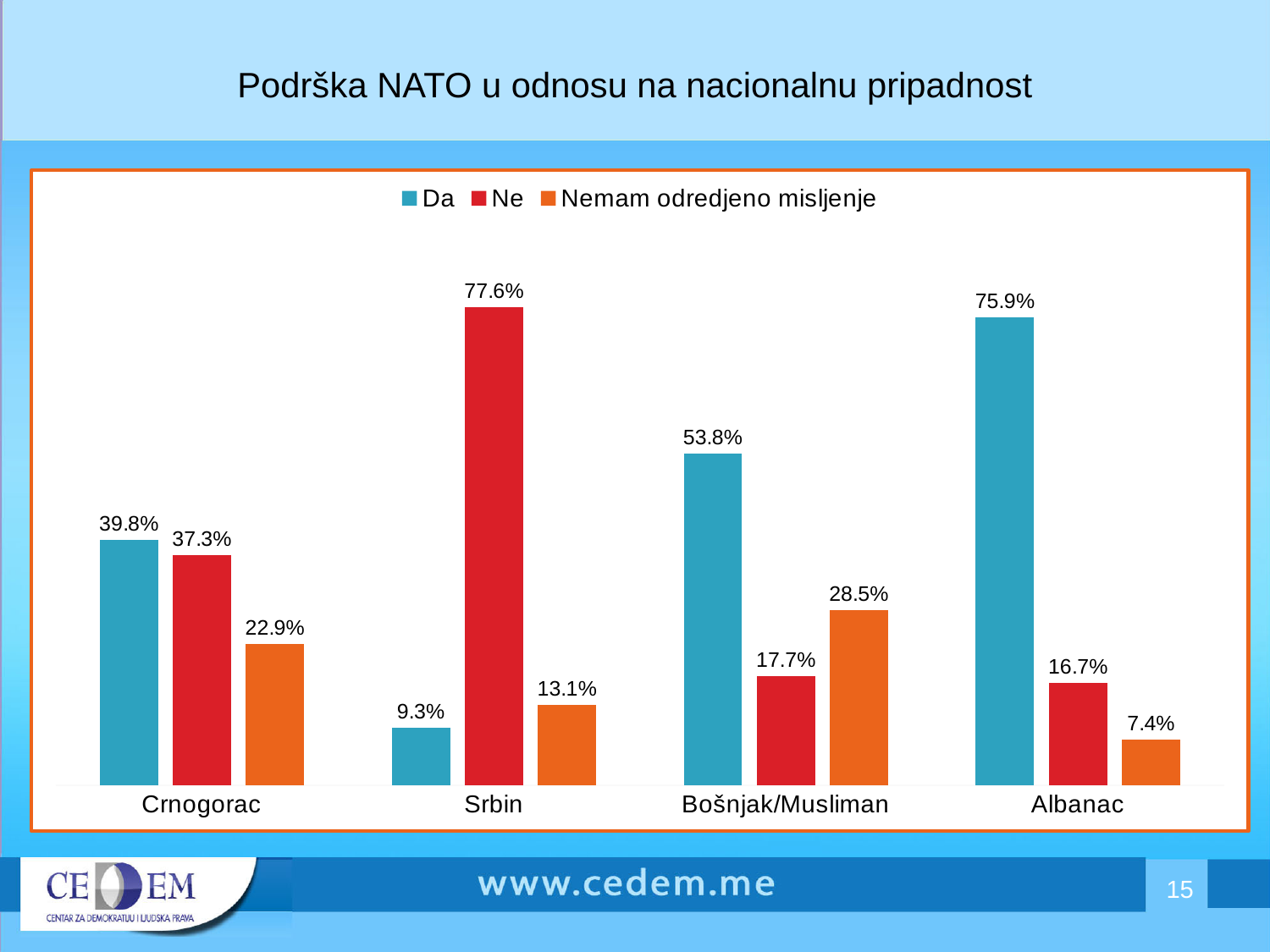
Which colour represents the "Ne" series? Red What kind of chart is shown on the slide? Bar chart How many series does the legend list? 3 How many categories are shown on the x axis? 4 What is the difference between the "Ne" value for Srbin and the "Ne" value for Crnogorac? 40.3% What is the title of the slide? Podrška NATO u odnosu na nacionalnu pripadnost What is the value of "Da" for Srbin? 9.3% Which category has the highest "Da" value? Albanac What is the value of "Ne" for Albanac? 16.7% Which is larger for Crnogorac: the "Da" value or the "Ne" value? Da Which category has the lowest "Nemam odredjeno misljenje" value? Albanac What is the value of "Nemam odredjeno misljenje" for Bošnjak/Musliman? 28.5%